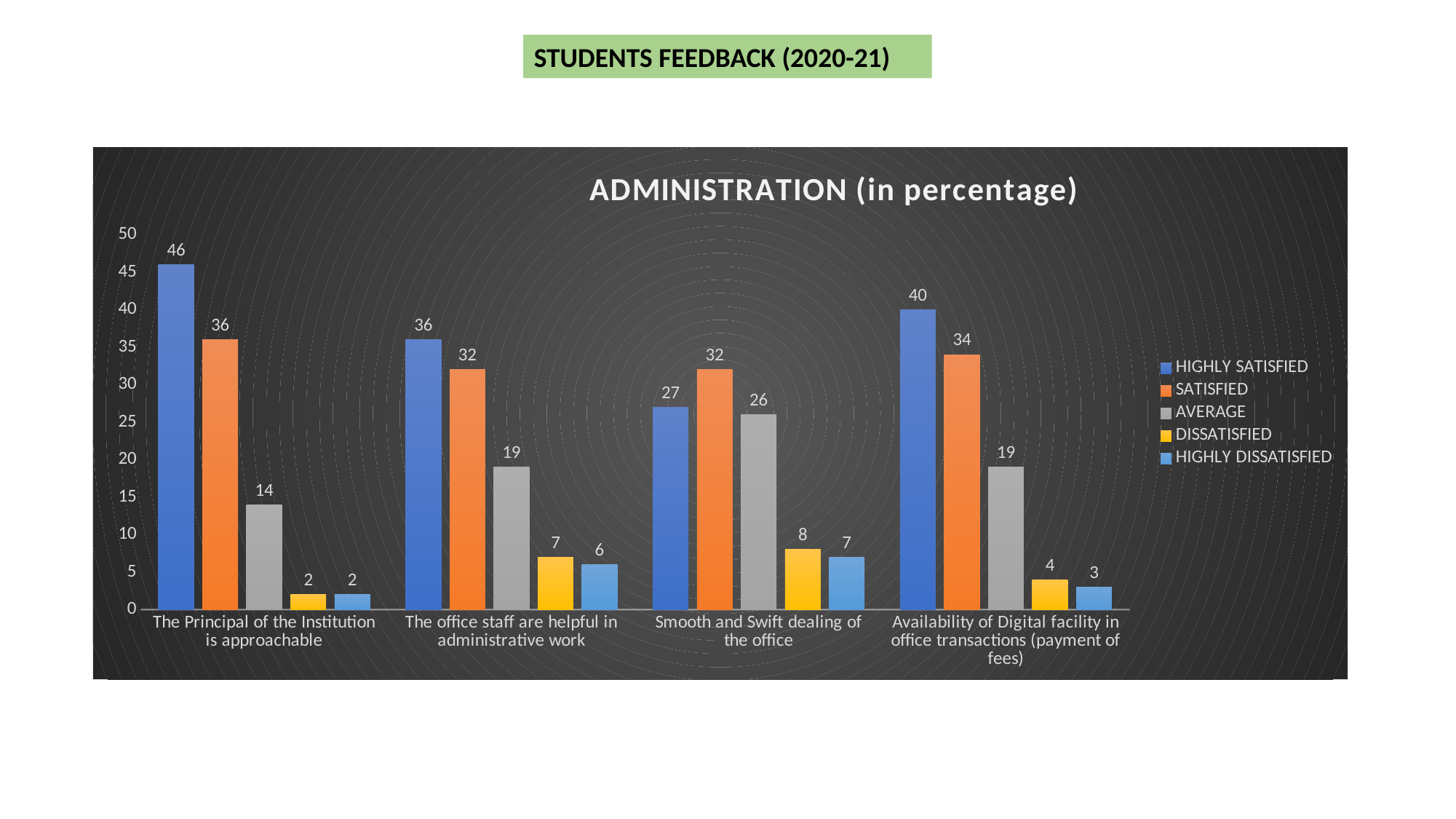
Which category has the highest HIGHLY SATISFIED value? The Principal of the Institution is approachable What is the DISSATISFIED value for "Availability of Digital facility in office transactions (payment of fees)"? 4 How many series does the legend list? 5 What is the difference between the SATISFIED and HIGHLY SATISFIED values for "Smooth and Swift dealing of the office"? 5 Is the SATISFIED value for "Availability of Digital facility in office transactions (payment of fees)" greater or less than 30? greater Which is larger for "The office staff are helpful in administrative work": HIGHLY SATISFIED or SATISFIED? HIGHLY SATISFIED How many categories are shown on the x axis? 4 Which category has the lowest HIGHLY SATISFIED value? Smooth and Swift dealing of the office What is the title of the chart? ADMINISTRATION (in percentage) What kind of chart is shown? Bar chart What is the AVERAGE value for "Smooth and Swift dealing of the office"? 26 What is the HIGHLY SATISFIED value for "The Principal of the Institution is approachable"? 46